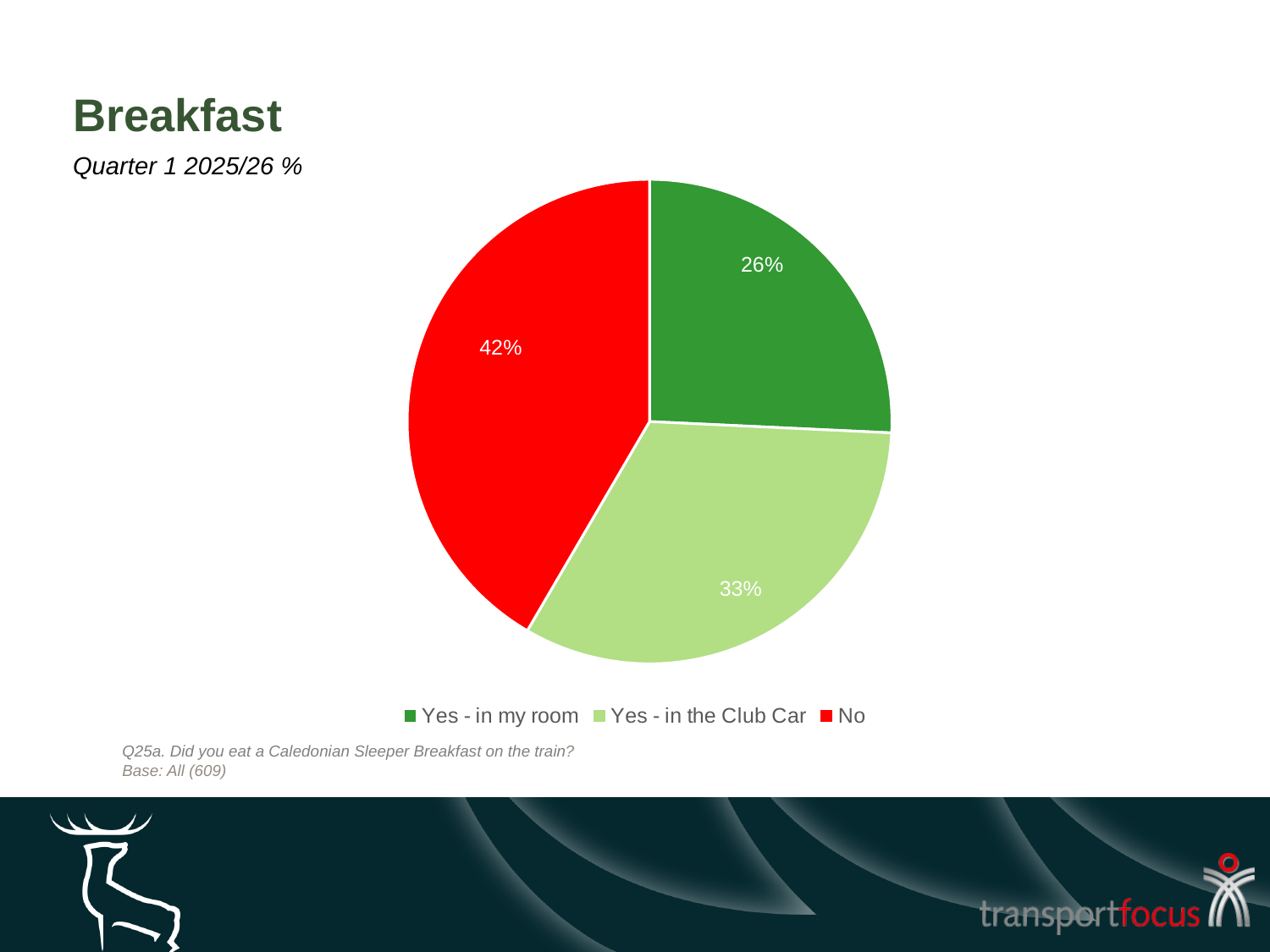
What colour is the 'No' slice in the pie chart? Red What is the difference in percentage points between 'Yes - in the Club Car' and 'Yes - in my room'? 7 Which response has the largest share of the pie? No What kind of chart is shown on the slide? Pie chart Which is larger: the share for 'Yes - in the Club Car' or the share for 'Yes - in my room'? Yes - in the Club Car How many entries does the legend list? 3 What percentage of respondents said 'No' to eating a Caledonian Sleeper Breakfast on the train? 42% What percentage of respondents ate breakfast in their room? 26% Which response has the smallest share of the pie? Yes - in my room How many slices does the pie chart have? 3 What percentage of respondents ate breakfast in the Club Car? 33% What is the difference in percentage points between 'No' and 'Yes - in my room'? 16